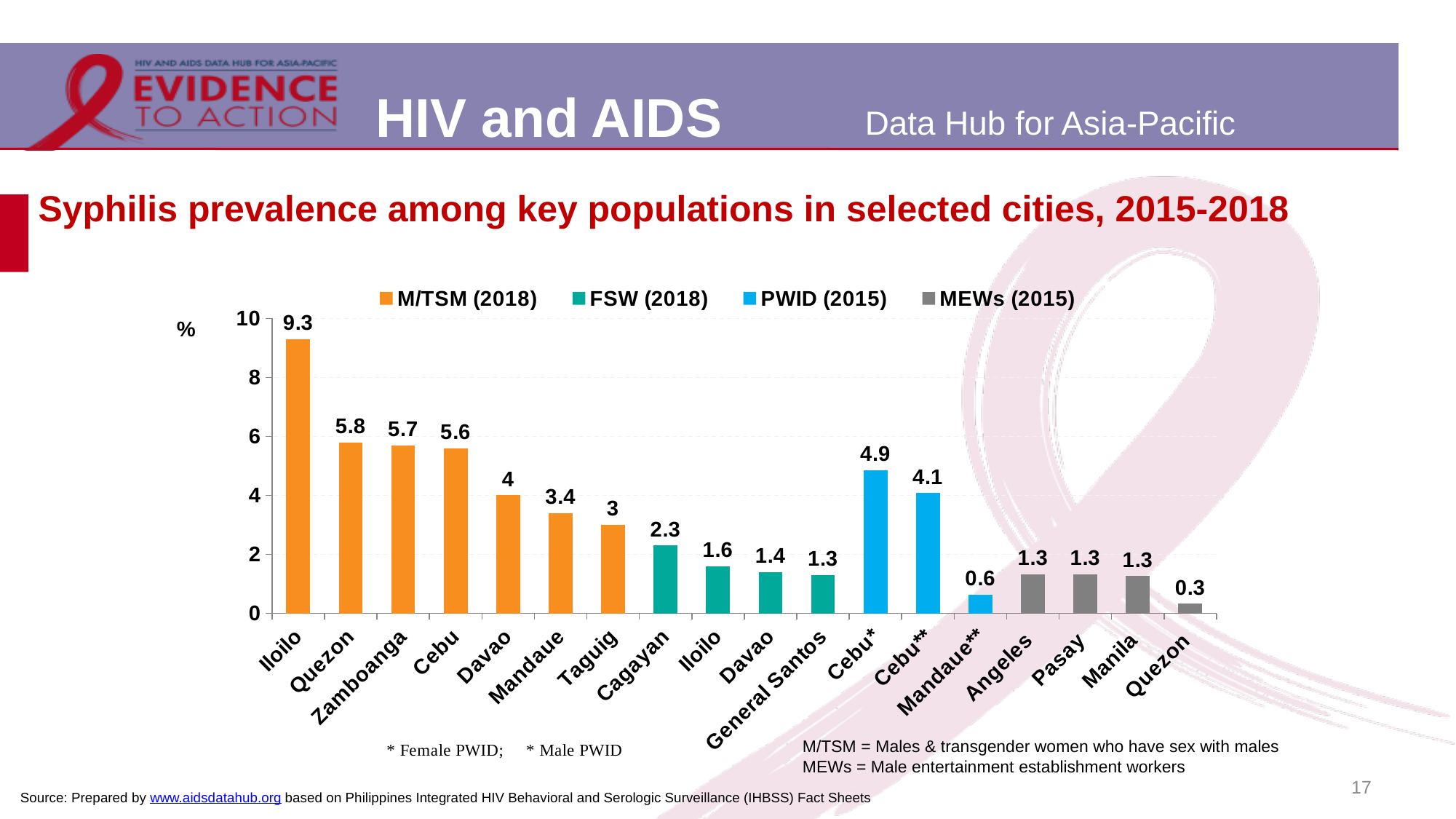
What is the value shown for Cagayan in the FSW (2018) series? 2.3 How many bars are plotted on the chart in total? 18 Which is larger: the M/TSM (2018) value for Davao or the PWID (2015) value for Cebu*? PWID (2015) value for Cebu* Which bar has the lowest value on the chart? Quezon (MEWs 2015) What is the difference between the Cebu* and Cebu** values in the PWID (2015) series? 0.8 Within the M/TSM (2018) series, do the values rise or fall from Iloilo to Taguig? Fall Which bar has the highest value on the chart? Iloilo (M/TSM 2018) What kind of chart is shown on the slide? Bar chart What is the value shown for Quezon in the MEWs (2015) series? 0.3 What is the value shown for Cebu* in the PWID (2015) series? 4.9 How many series does the legend list? 4 What is the syphilis prevalence value shown for Iloilo in the M/TSM (2018) series? 9.3